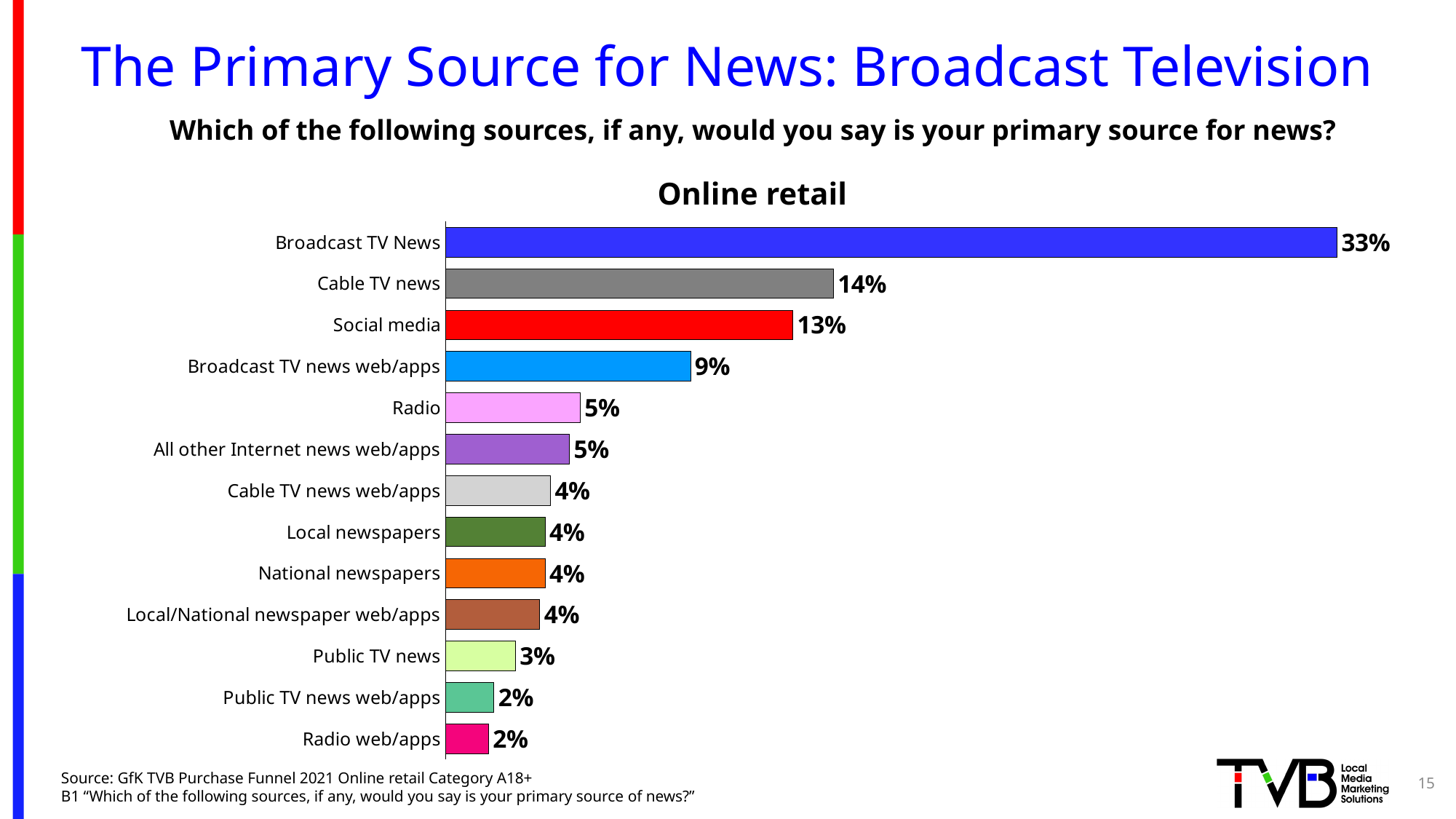
Which is larger, the value for Radio or the value for Public TV news web/apps? Radio What is the value shown for Public TV news? 3% What is the value shown for Social media? 13% What is the difference between the values for Broadcast TV News and Cable TV news? 19% What colour is the bar for Social media? Red What is the value shown for Broadcast TV news web/apps? 9% How many sources (categories) are shown in the chart? 13 Which source has the highest value in the chart? Broadcast TV News What kind of chart is shown on the slide? Bar chart What is the title of the chart? Online retail What is the difference between the values for Cable TV news and Social media? 1% What percentage of respondents named Broadcast TV News as their primary source for news? 33%